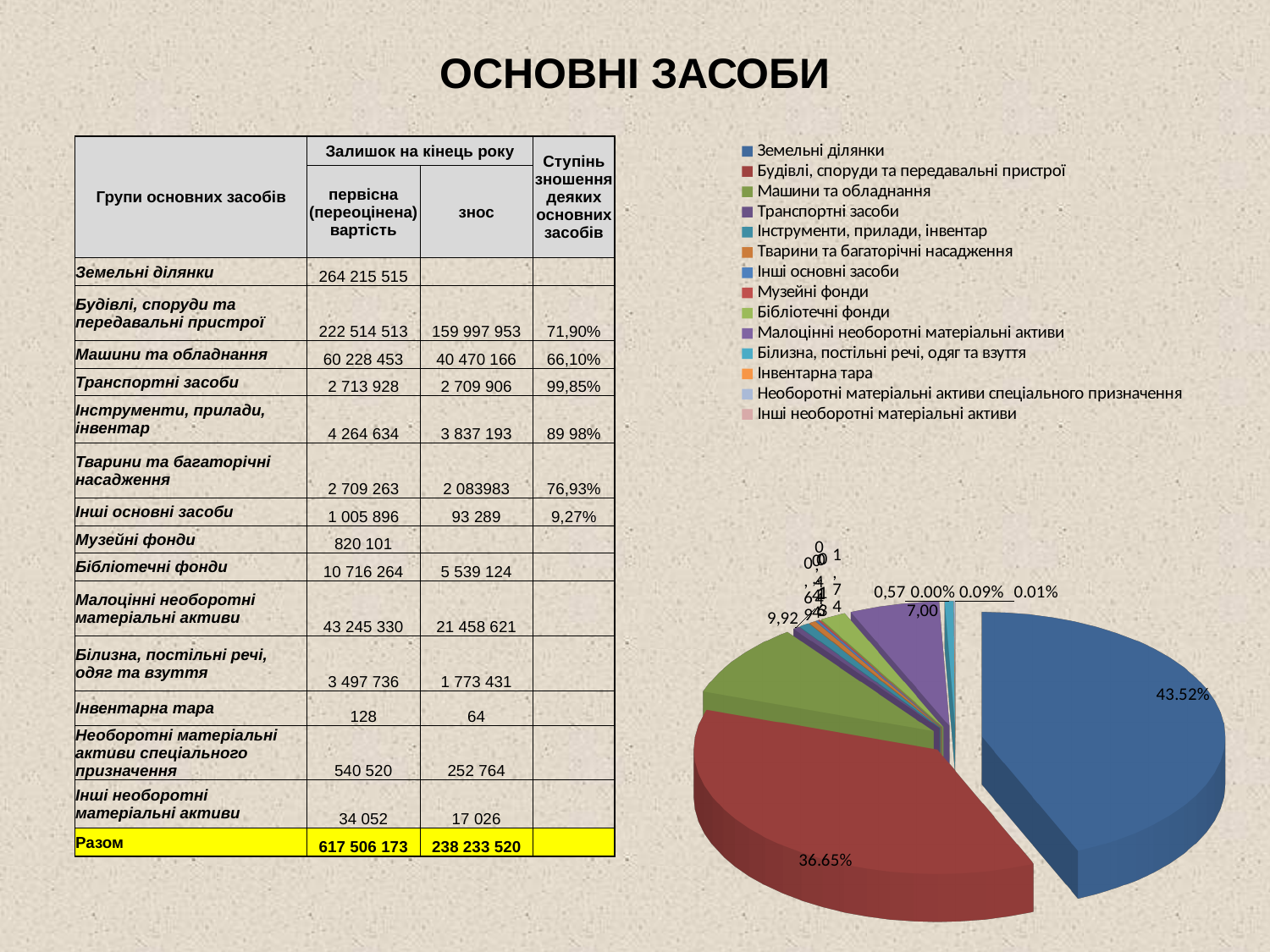
What share of the pie does Будівлі, споруди та передавальні пристрої have? 36.65% What kind of chart is shown on the slide? pie chart Which category is listed first in the pie chart's legend? Земельні ділянки How many entries does the pie chart's legend list? 14 Which slice is larger: Будівлі, споруди та передавальні пристрої or Машини та обладнання? Будівлі, споруди та передавальні пристрої Which slice is larger: Земельні ділянки or Будівлі, споруди та передавальні пристрої? Земельні ділянки What value is labelled on the Малоцінні необоротні матеріальні активи slice? 7,00 What colour is the largest slice of the pie chart? blue What is the difference in percentage points between the Земельні ділянки slice (43.52%) and the Будівлі, споруди та передавальні пристрої slice (36.65%)? 6.87 Which category has the largest slice in the pie chart? Земельні ділянки What share of the pie does Земельні ділянки have? 43.52%